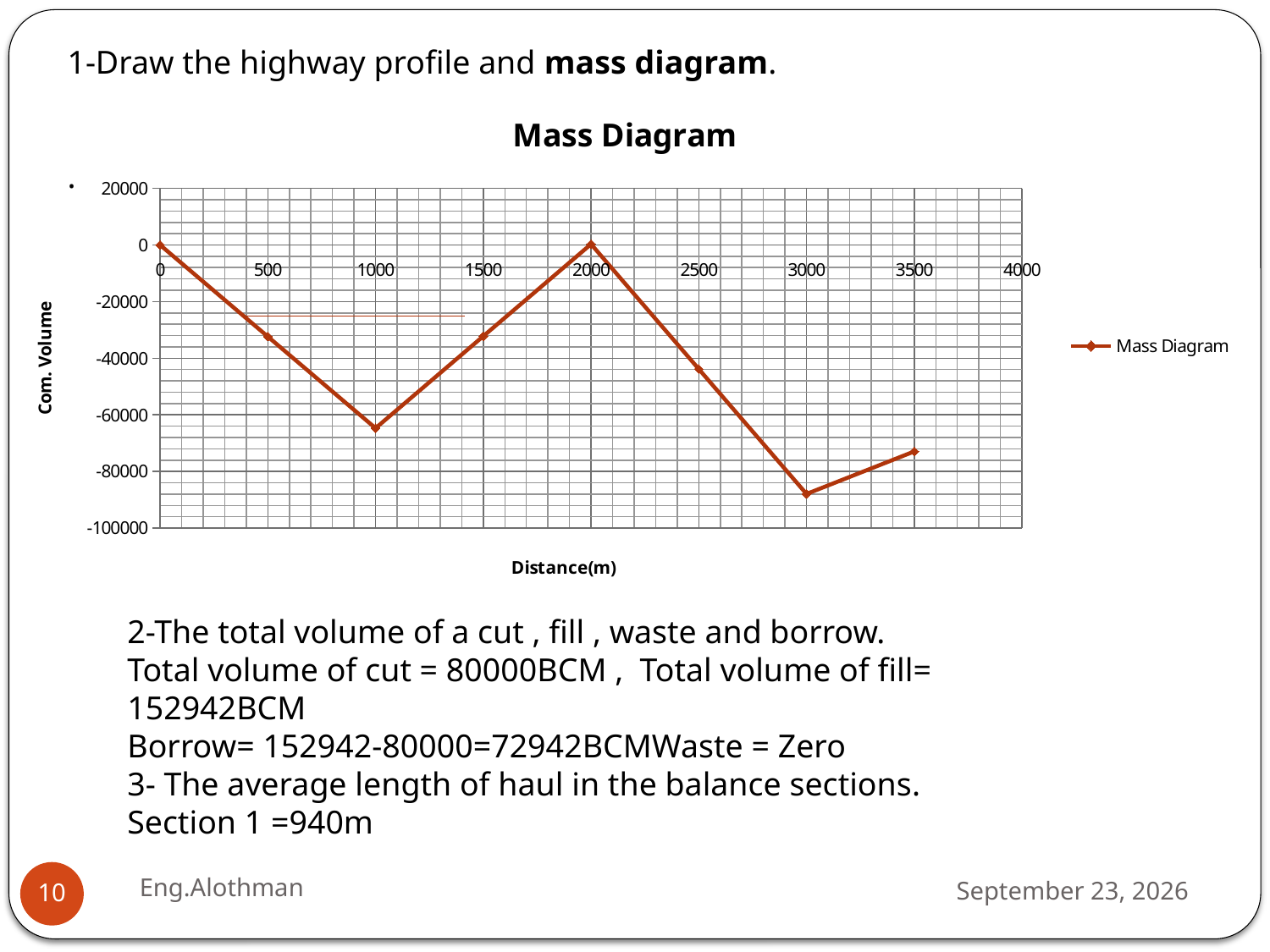
Is the value of the Mass Diagram at distance 1000 greater or less than -60000? less Is the value of the Mass Diagram at distance 3000 greater or less than -80000? less What is the value of the Mass Diagram at distance 0? 0 At which distance does the Mass Diagram reach its lowest value? 3000 What is the label of the vertical axis of the Mass Diagram? Com. Volume How many data points are plotted on the Mass Diagram line? 8 What kind of chart is the Mass Diagram? line chart What is the label of the horizontal axis of the Mass Diagram? Distance(m) Is the value of the Mass Diagram at distance 3500 greater or less than -80000? greater Between distance 2000 and distance 3000, does the Mass Diagram rise or fall? fall Which is larger on the Mass Diagram, the value at distance 1000 or the value at distance 3000? 1000 How many series does the legend of the Mass Diagram list? 1